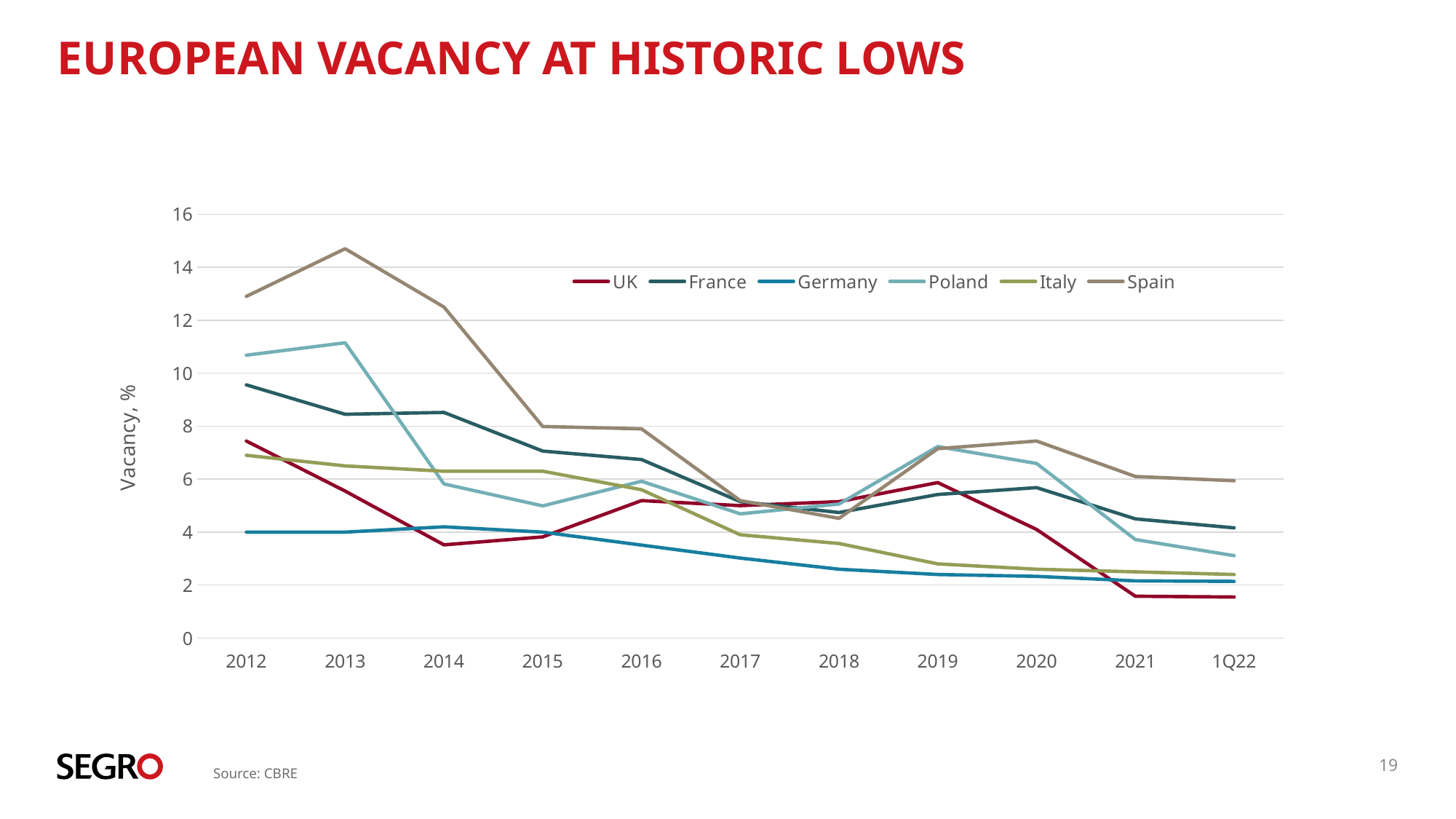
Which country had the lowest vacancy rate in 1Q22? UK What source is cited for the chart? CBRE Is the vacancy rate for the UK in 1Q22 greater or less than 2? less Which country had the highest vacancy rate in 2013? Spain Does the vacancy rate for Italy generally rise or fall from 2012 to 1Q22? fall What kind of chart is shown on the slide? line chart Is the vacancy rate for Spain in 2013 greater or less than 14? greater Which had the higher vacancy rate in 2012, Poland or France? Poland How many time points are shown along the x axis? 11 How many series does the legend list? 6 Is the vacancy rate for France in 2012 greater or less than 8? greater What is the label on the y axis? Vacancy, %